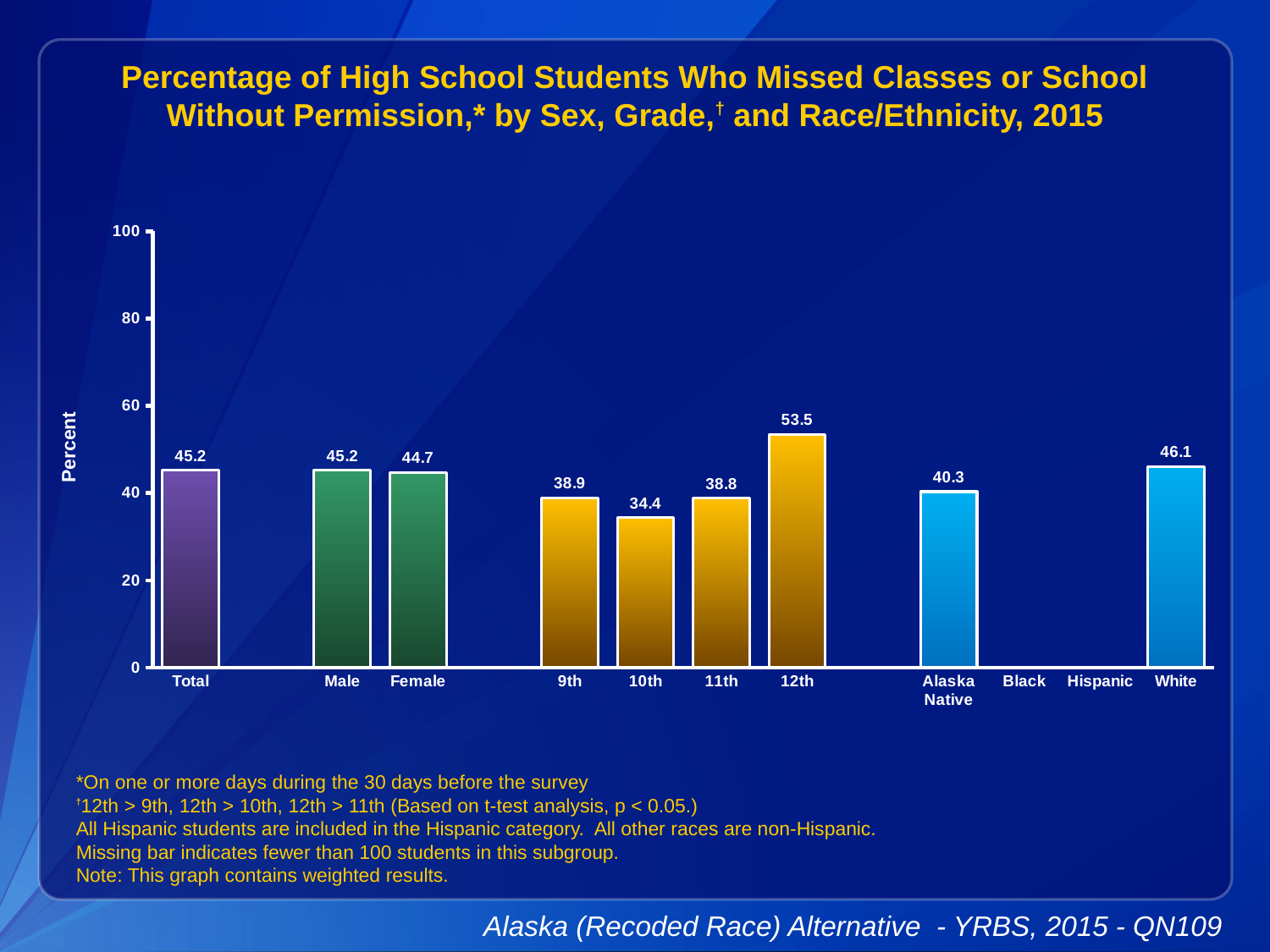
What is the label of the y axis? Percent What kind of chart is shown? bar chart What is the value for Female? 44.7 Which is larger, the value for White or the value for Alaska Native? White What is the value for Total? 45.2 How many bars are plotted on the chart? 9 Which grade has the highest value? 12th Is the value for 12th grade greater or less than 60? less What is the difference between the 12th grade value and the 10th grade value? 19.1 What is the value for 12th grade? 53.5 What is the value for Alaska Native? 40.3 Which grade has the lowest value? 10th